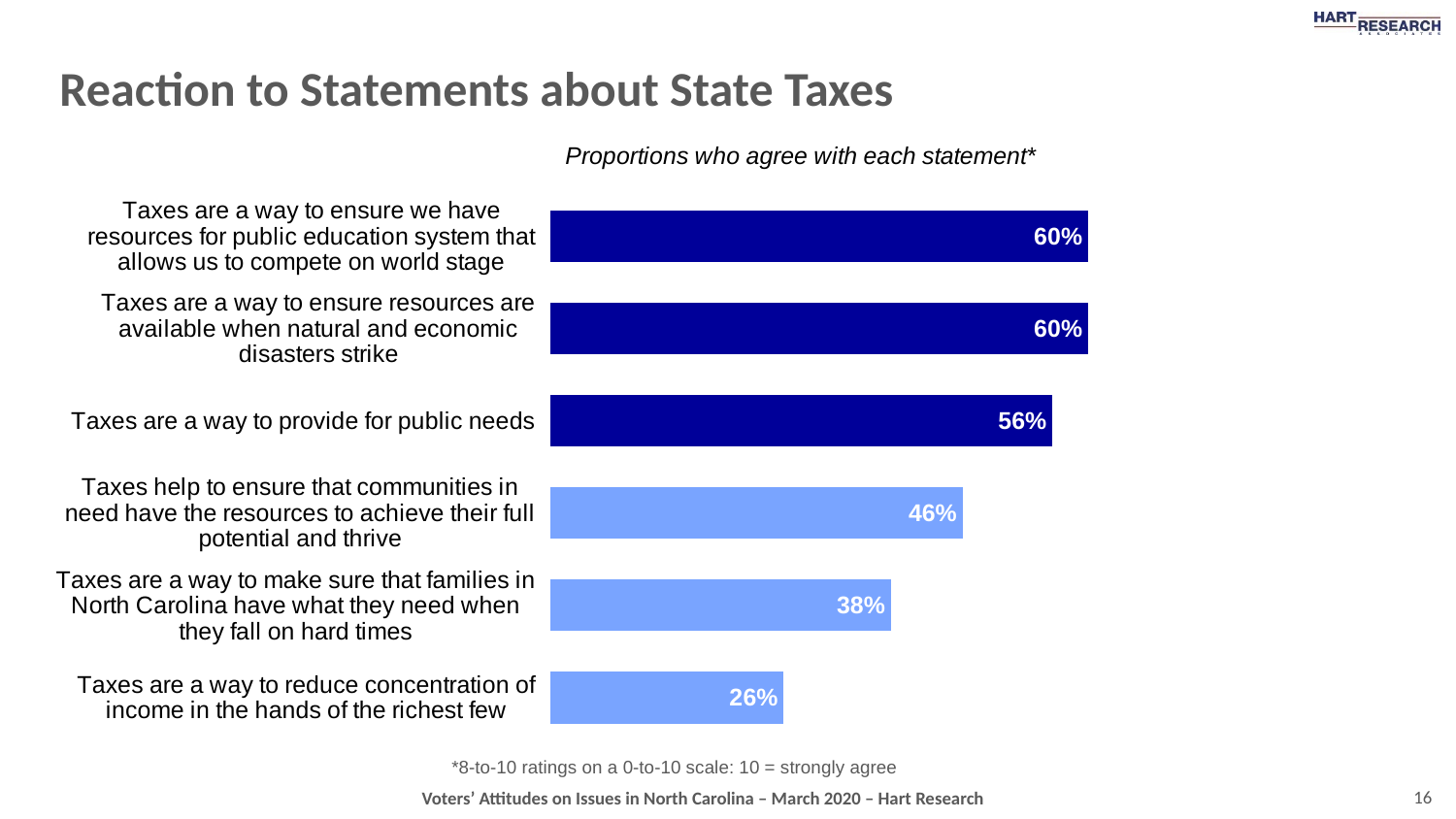
What kind of chart is shown on the slide? Bar chart What percentage agree that taxes are a way to provide for public needs? 56% How many statements are shown in the chart? 6 What percentage agree that taxes help to ensure that communities in need have the resources to achieve their full potential and thrive? 46% Which statement has the lowest proportion of agreement? Taxes are a way to reduce concentration of income in the hands of the richest few What is the difference in agreement between the statement about public education and the statement about communities in need? 14 percentage points What is the subtitle shown above the chart? Proportions who agree with each statement* What percentage agree that taxes are a way to make sure that families in North Carolina have what they need when they fall on hard times? 38% What percentage agree that taxes are a way to reduce concentration of income in the hands of the richest few? 26% Which has a higher proportion of agreement: the statement about natural and economic disasters or the statement about families falling on hard times? The statement about natural and economic disasters How many bars are shown in the lighter blue colour? 3 What is the difference in agreement between the statement about providing for public needs and the statement about reducing concentration of income in the hands of the richest few? 30 percentage points